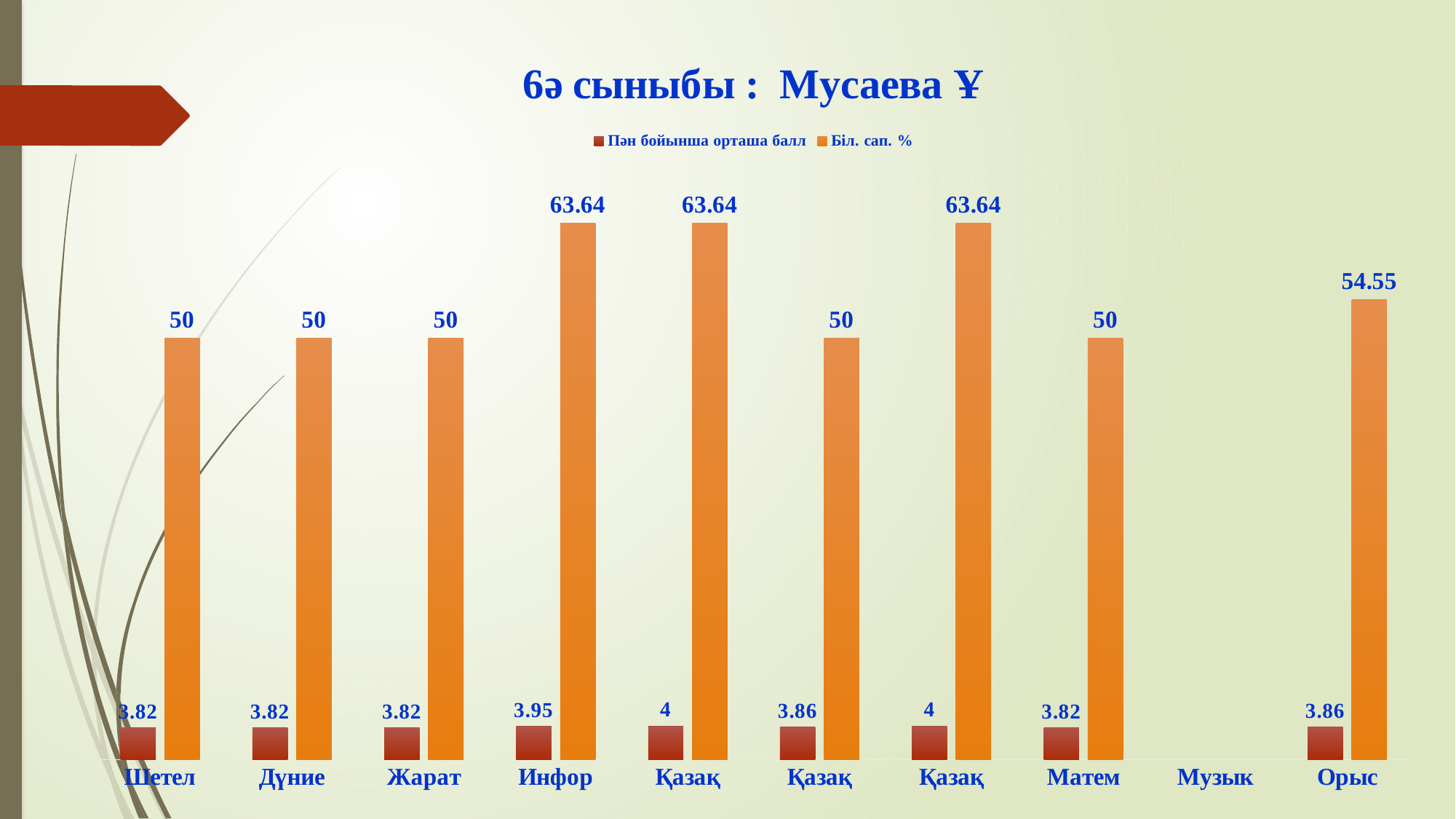
Which has the larger Біл. сап. % value, Инфор or Дүние? Инфор How many categories are shown on the x axis of the chart? 10 What is the Пән бойынша орташа балл value for Орыс? 3.86 What is the difference between the Пән бойынша орташа балл values for Инфор and Шетел? 0.13 What is the Біл. сап. % value for Матем? 50 What is the title of the chart? 6ә сыныбы : Мусаева Ұ Which has the larger Біл. сап. % value, Орыс or Матем? Орыс What is the Біл. сап. % value for Орыс? 54.55 How many series does the legend list? 2 What is the difference between the Біл. сап. % values for Инфор and Орыс? 9.09 What is the Пән бойынша орташа балл value for Инфор? 3.95 What kind of chart is shown on the slide? Bar chart